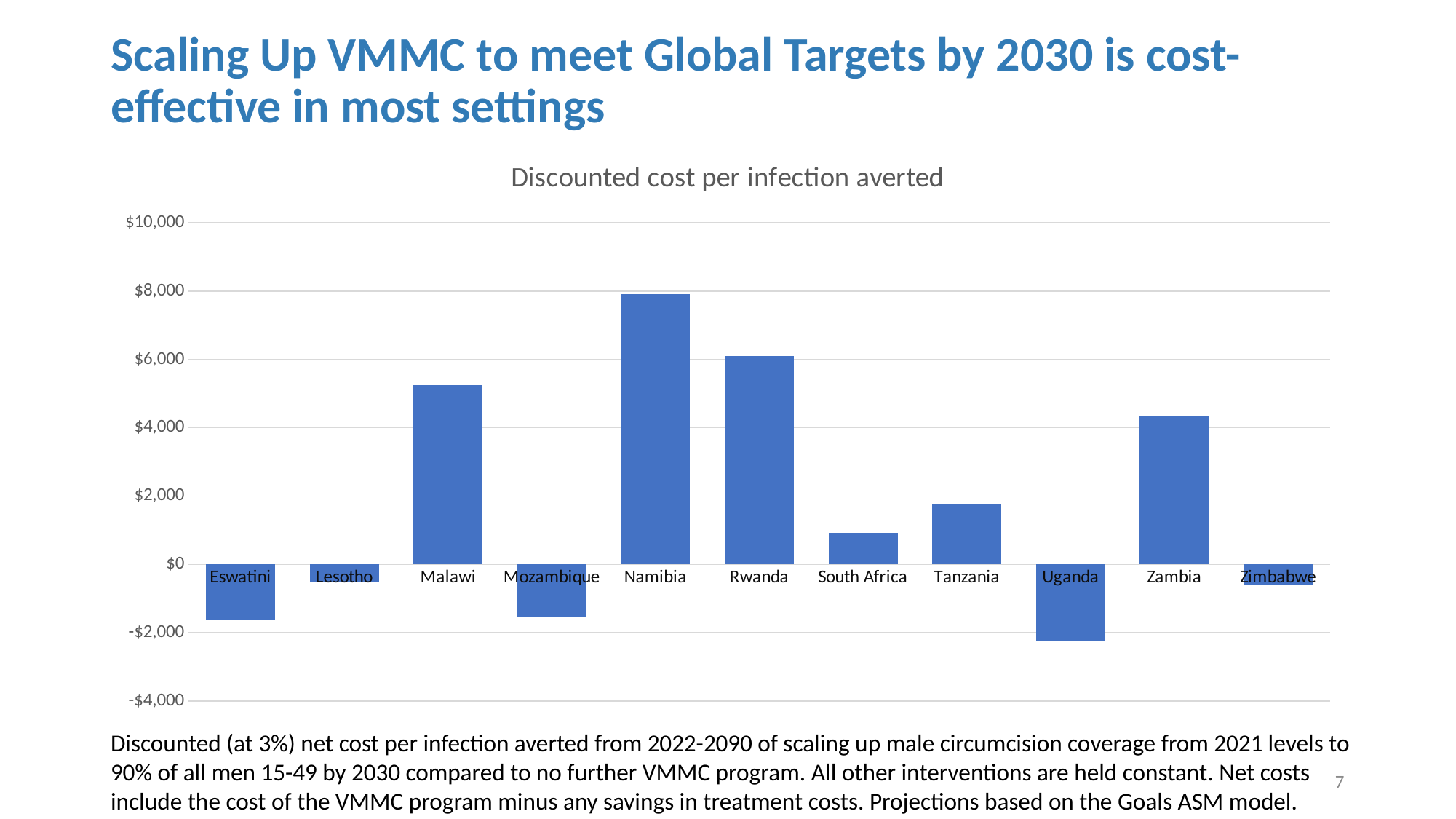
How many countries are shown on the x axis of the chart? 11 Which country has the lowest (most negative) discounted cost per infection averted? Uganda Which country has the highest discounted cost per infection averted? Namibia Which has the larger discounted cost per infection averted, Rwanda or Malawi? Rwanda How many countries have a negative discounted cost per infection averted? 5 Is the value for Tanzania greater or less than $2,000? less Is the value for Namibia greater or less than $6,000? greater What kind of chart is shown on the slide? bar chart Is the value for Uganda greater or less than -$2,000? less What is the title of the chart? Discounted cost per infection averted Which has the larger discounted cost per infection averted, Malawi or Zambia? Malawi